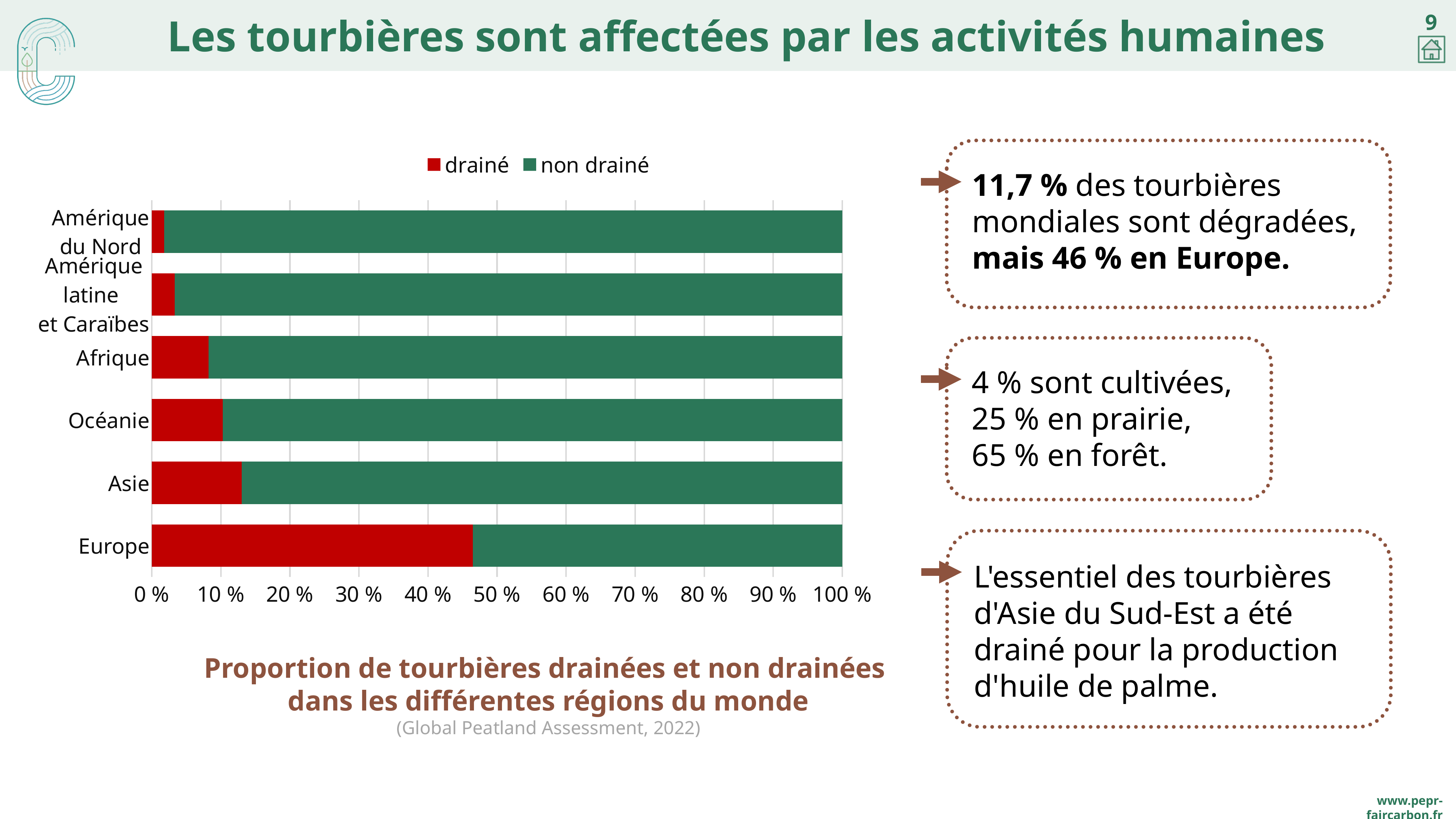
What is the source cited below the chart? Global Peatland Assessment, 2022 How many series does the chart legend list? 2 Which has a larger drained (drainé) share, Asie or Afrique? Asie What is the total of the stacked bar for Europe? 100 % Which region has the lowest proportion of drained (drainé) peatlands? Amérique du Nord Which region has the highest proportion of drained (drainé) peatlands? Europe Is the drained (drainé) share for Afrique greater or less than 10 %? less What kind of chart is shown on the slide? Stacked bar chart Which has a larger non-drained (non drainé) share, Europe or Océanie? Océanie How many regions are listed on the chart? 6 Is the drained (drainé) share for Europe greater or less than 40 %? greater Is the drained (drainé) share for Asie greater or less than 20 %? less